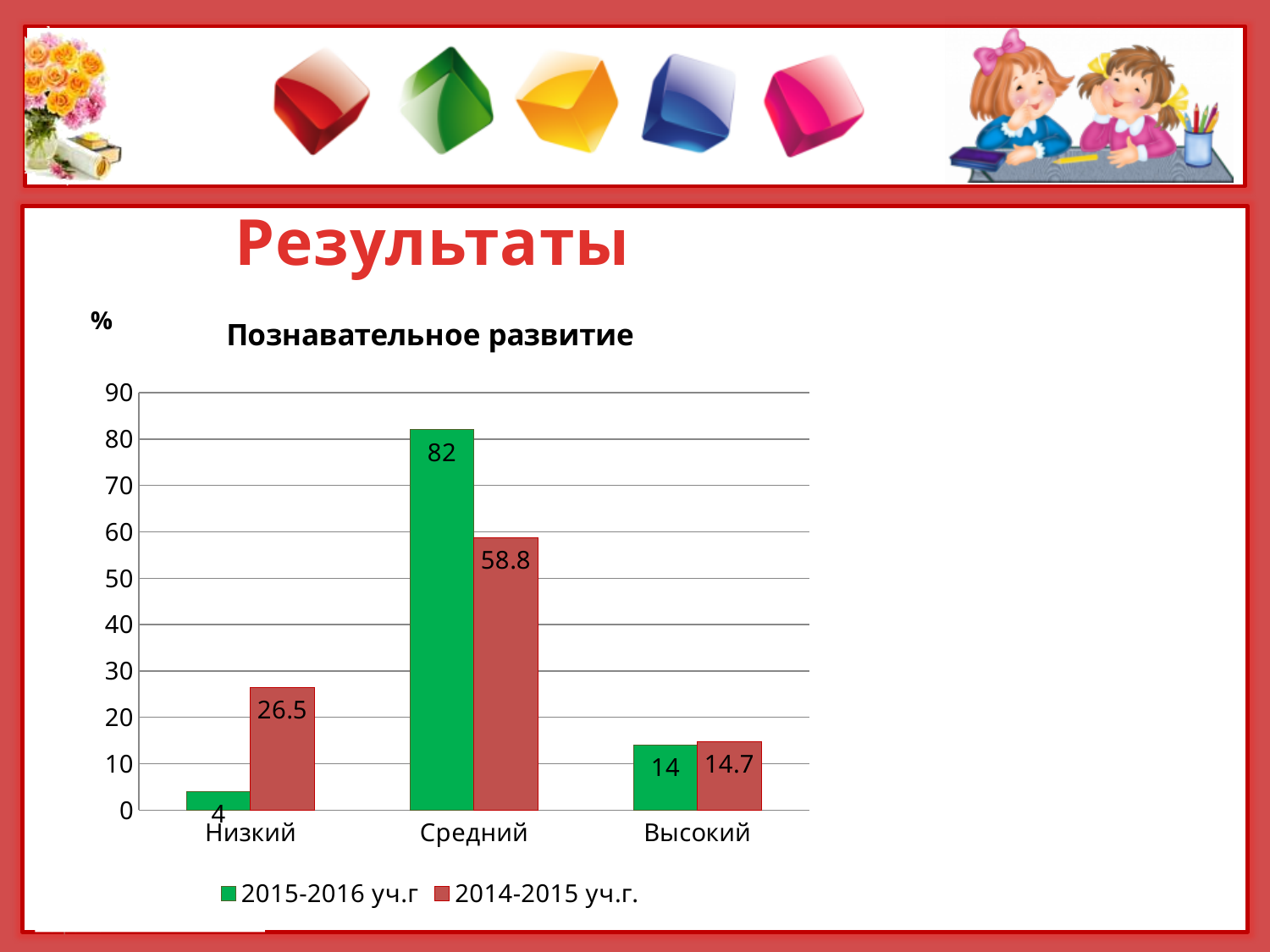
What kind of chart is shown on the slide? Bar chart What is the value for Низкий in the 2014-2015 уч.г. series? 26.5 What is the value for Низкий in the 2015-2016 уч.г series? 4 Which category has the highest value in the 2015-2016 уч.г series? Средний What is the difference between the 2015-2016 уч.г and 2014-2015 уч.г. values for Средний? 23.2 How many series does the legend list? 2 What is the value for Средний in the 2015-2016 уч.г series? 82 How many categories are shown on the x axis? 3 Which category has the lowest value in the 2014-2015 уч.г. series? Высокий For Низкий, which series has the larger value: 2015-2016 уч.г or 2014-2015 уч.г.? 2014-2015 уч.г. What is the title of the chart? Познавательное развитие What is the value for Высокий in the 2014-2015 уч.г. series? 14.7